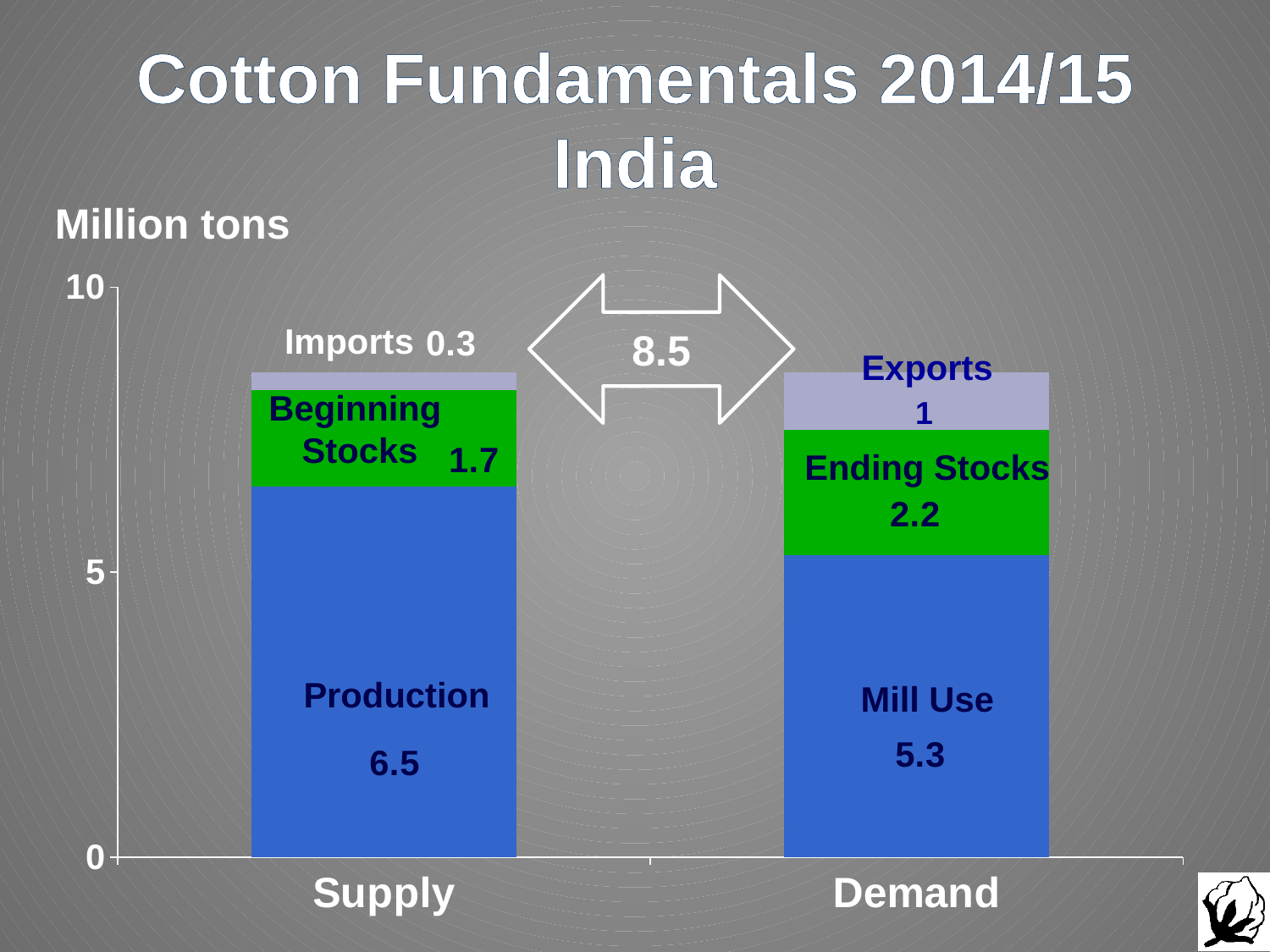
What is the value of Ending Stocks in the Demand bar? 2.2 What is the difference between Production and Mill Use? 1.2 What is the value of Mill Use in the Demand bar? 5.3 How many bars are shown on the x axis? 2 Which is larger, Ending Stocks or Beginning Stocks? Ending Stocks What is the value of Beginning Stocks in the Supply bar? 1.7 What unit is the chart measured in? Million tons What is the value of Imports? 0.3 What is the value of Exports? 1 What is the total of the Supply bar (Production + Beginning Stocks + Imports)? 8.5 What is the value of Production in the Supply bar? 6.5 Is the value for Mill Use greater or less than 5? greater